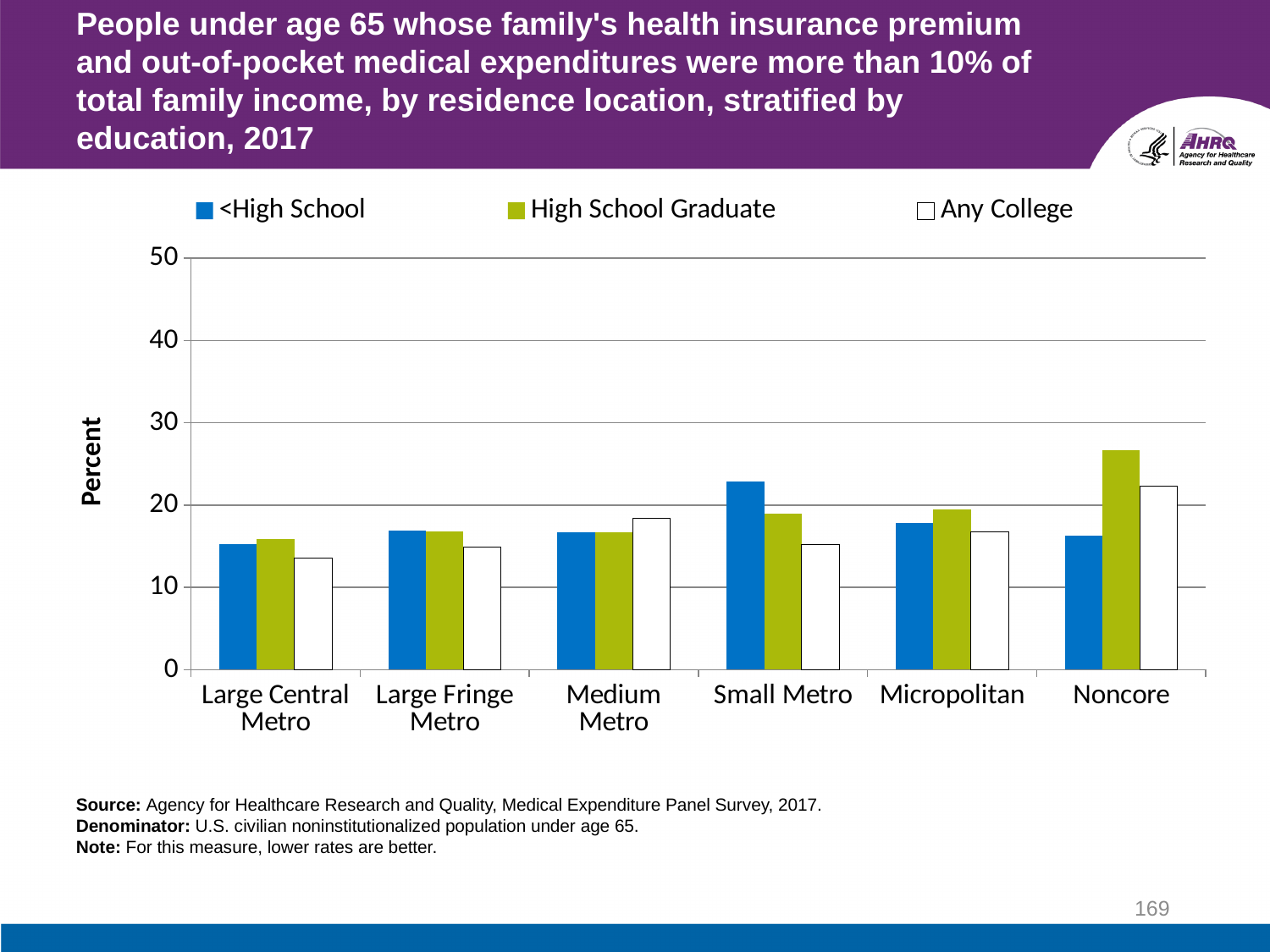
Which residence location has the highest value for the High School Graduate series? Noncore Is the Any College value for Noncore greater or less than 20? greater How many series does the legend list? 3 What is the label on the vertical axis of the chart? Percent How many residence location categories are shown on the x axis? 6 For Small Metro, which is larger: the <High School value or the Any College value? <High School What kind of chart is shown on the slide? bar chart Is the High School Graduate value for Noncore greater or less than 20? greater For Noncore, which is larger: the High School Graduate value or the <High School value? High School Graduate Is the Any College value for Large Central Metro greater or less than 20? less Which residence location has the highest value for the <High School series? Small Metro